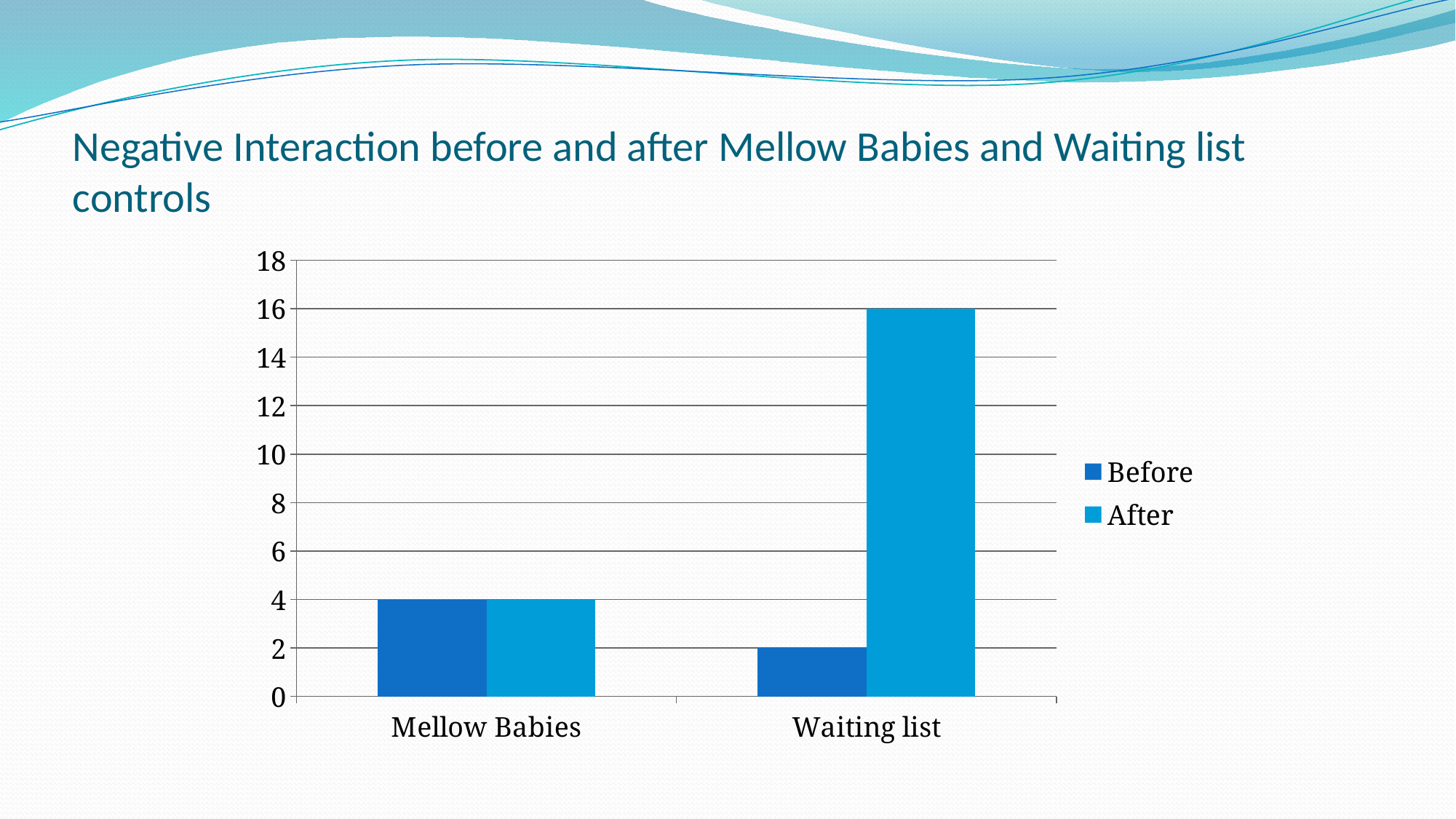
What is the difference between the After and Before values for Waiting list? 14 What is the After value for Waiting list? 16 Which category has the highest After value? Waiting list What are the two series named in the legend? Before and After What type of chart is shown on the slide? bar chart Which category has the lowest Before value? Waiting list How many categories are shown on the x axis? 2 What is the Before value for Mellow Babies? 4 What is the Before value for Waiting list? 2 What is the After value for Mellow Babies? 4 Is the After value for Waiting list greater or less than 10? greater How many series does the legend list? 2